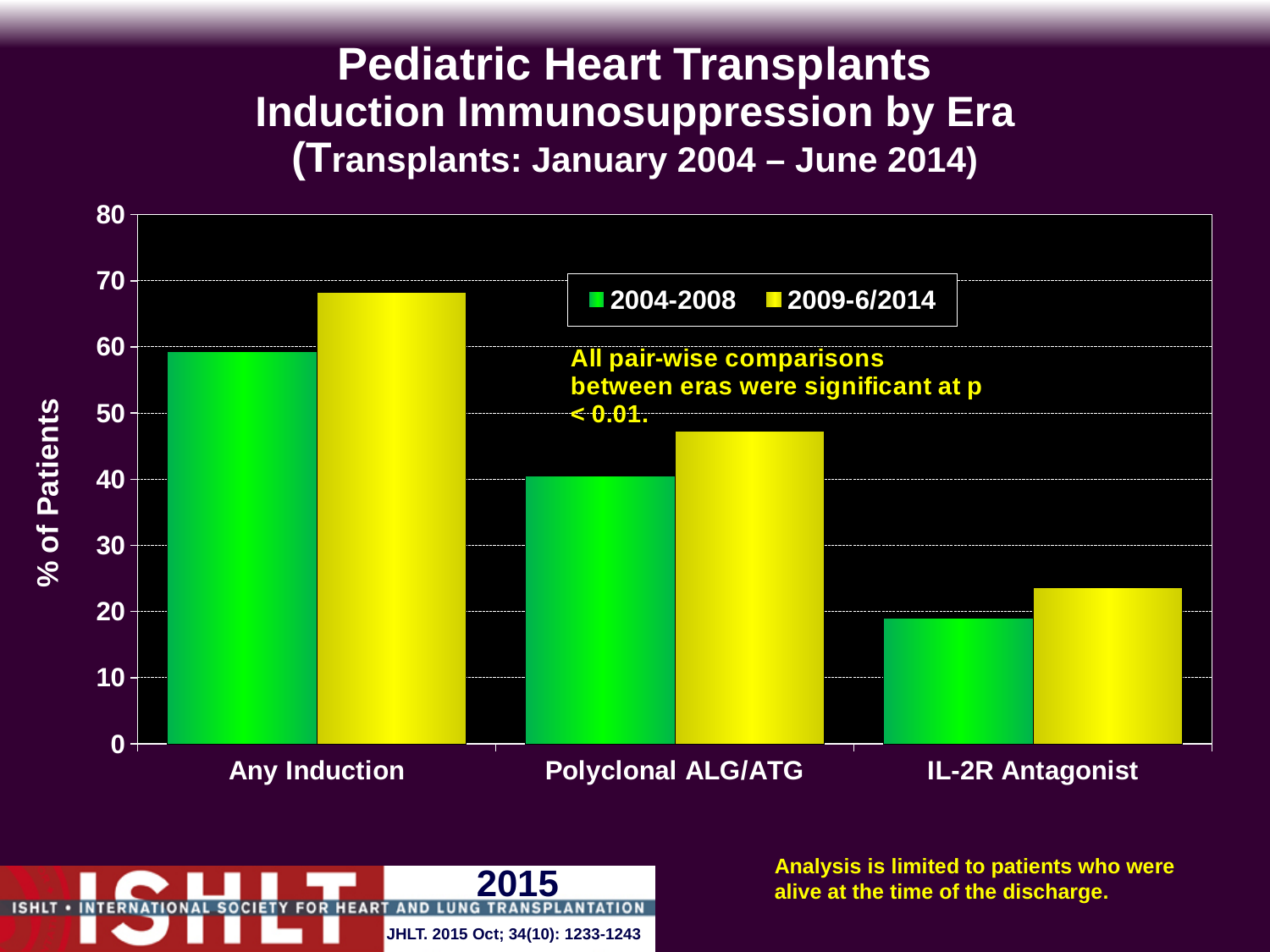
Which category has the lowest value for the 2004-2008 series? IL-2R Antagonist What is the label of the y axis? % of Patients Which is larger: the 2004-2008 value for Any Induction or the 2009-6/2014 value for Polyclonal ALG/ATG? 2004-2008 value for Any Induction How many series does the legend list? 2 Is the value for Any Induction in 2009-6/2014 greater or less than 60? greater What kind of chart is shown on the slide? bar chart Which category has the highest value for the 2009-6/2014 series? Any Induction Is the value for Polyclonal ALG/ATG in 2009-6/2014 greater or less than 50? less How many categories are shown on the x axis? 3 For Polyclonal ALG/ATG, which era has the larger value, 2004-2008 or 2009-6/2014? 2009-6/2014